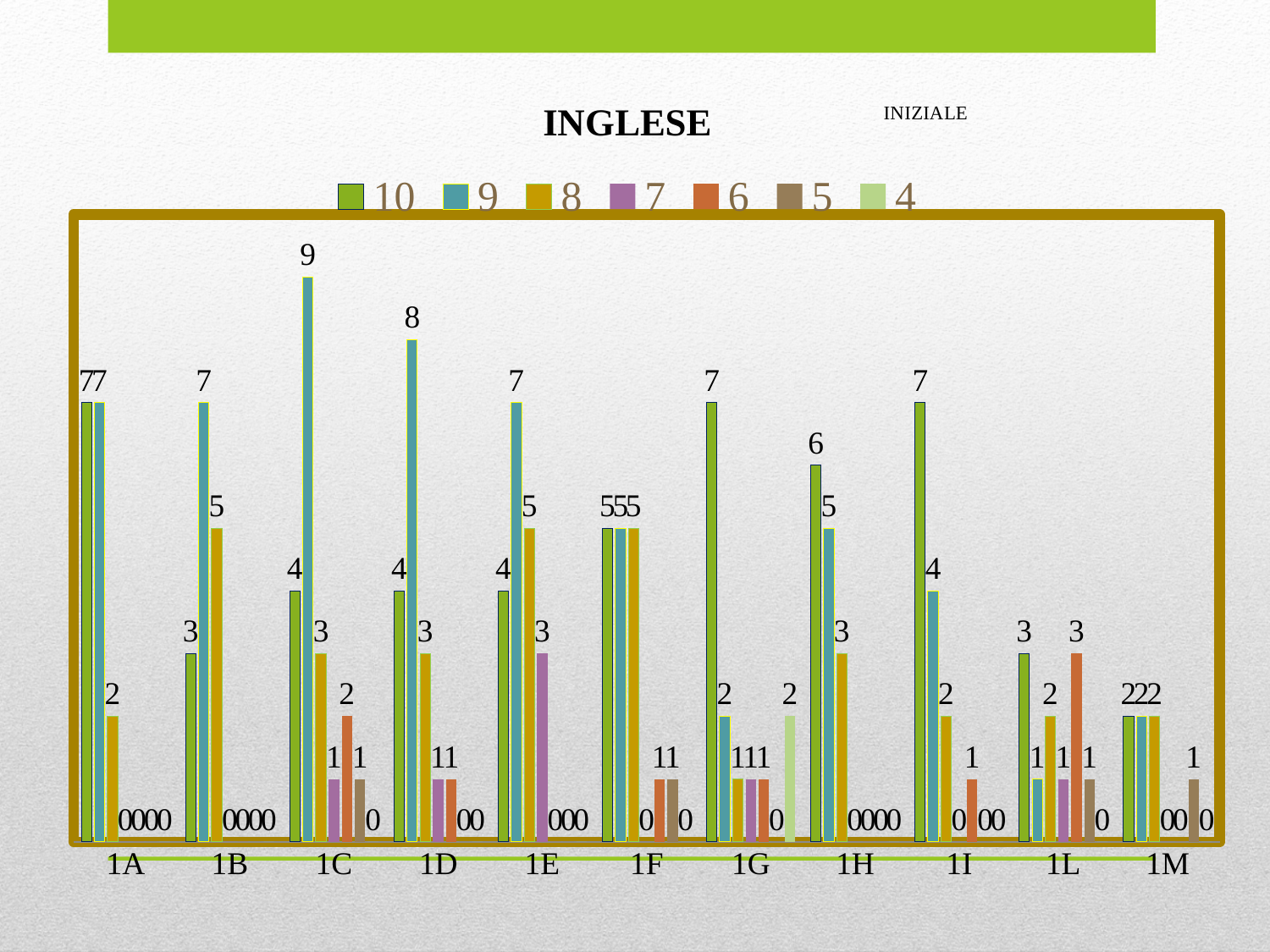
What is the total of all series values for category 1A? 16 What is the value of series 10 for category 1H? 6 Which category has the highest value for series 9? 1C What is the value of series 6 for category 1L? 3 What kind of chart is shown on the slide? bar chart Which is larger: the series 10 value for 1G or the series 10 value for 1L? 1G How many categories are shown on the x axis? 11 Which category has the highest value for series 4? 1G What is the value of series 9 for category 1C? 9 How many series does the legend list? 7 What is the difference between the series 9 value for 1D and the series 9 value for 1I? 4 What is the title of the chart? INGLESE